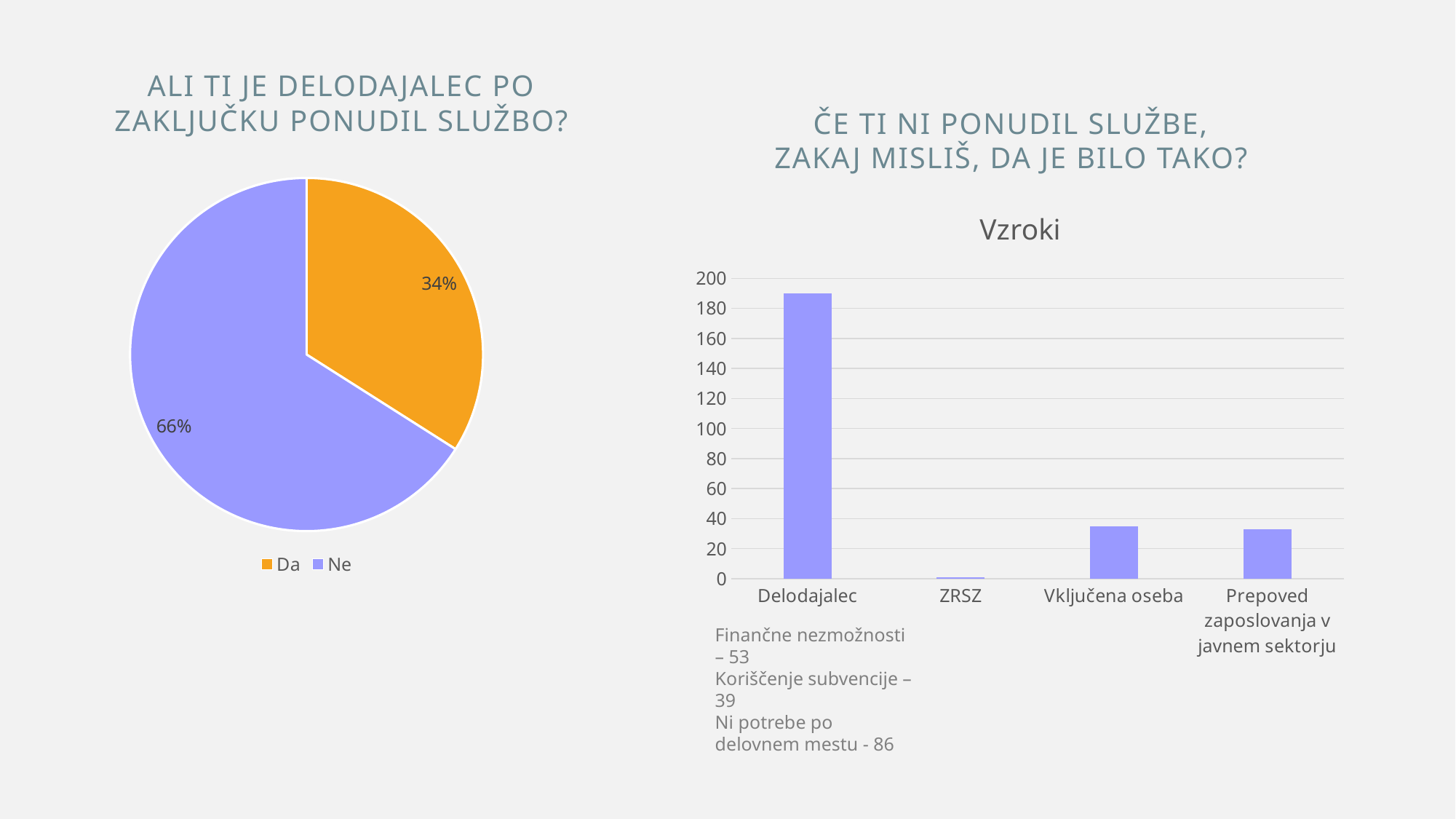
What kind of chart is the chart on the left? pie chart In the pie chart on the left, how many slices are there? 2 In the pie chart on the left, what share is labelled for Ne? 66% In the Vzroki chart, is the value for Vključena oseba greater or less than 40? less In the Vzroki chart, how many categories are shown on the x axis? 4 In the pie chart on the left, which slice is larger, Da or Ne? Ne In the Vzroki chart, is the value for Delodajalec greater or less than 180? greater What kind of chart is the Vzroki chart on the right? bar chart In the pie chart on the left, what colour is the Da slice? orange In the Vzroki chart, which category has the lowest bar? ZRSZ In the Vzroki chart, which category has the highest bar? Delodajalec In the pie chart on the left, what share is labelled for Da? 34%